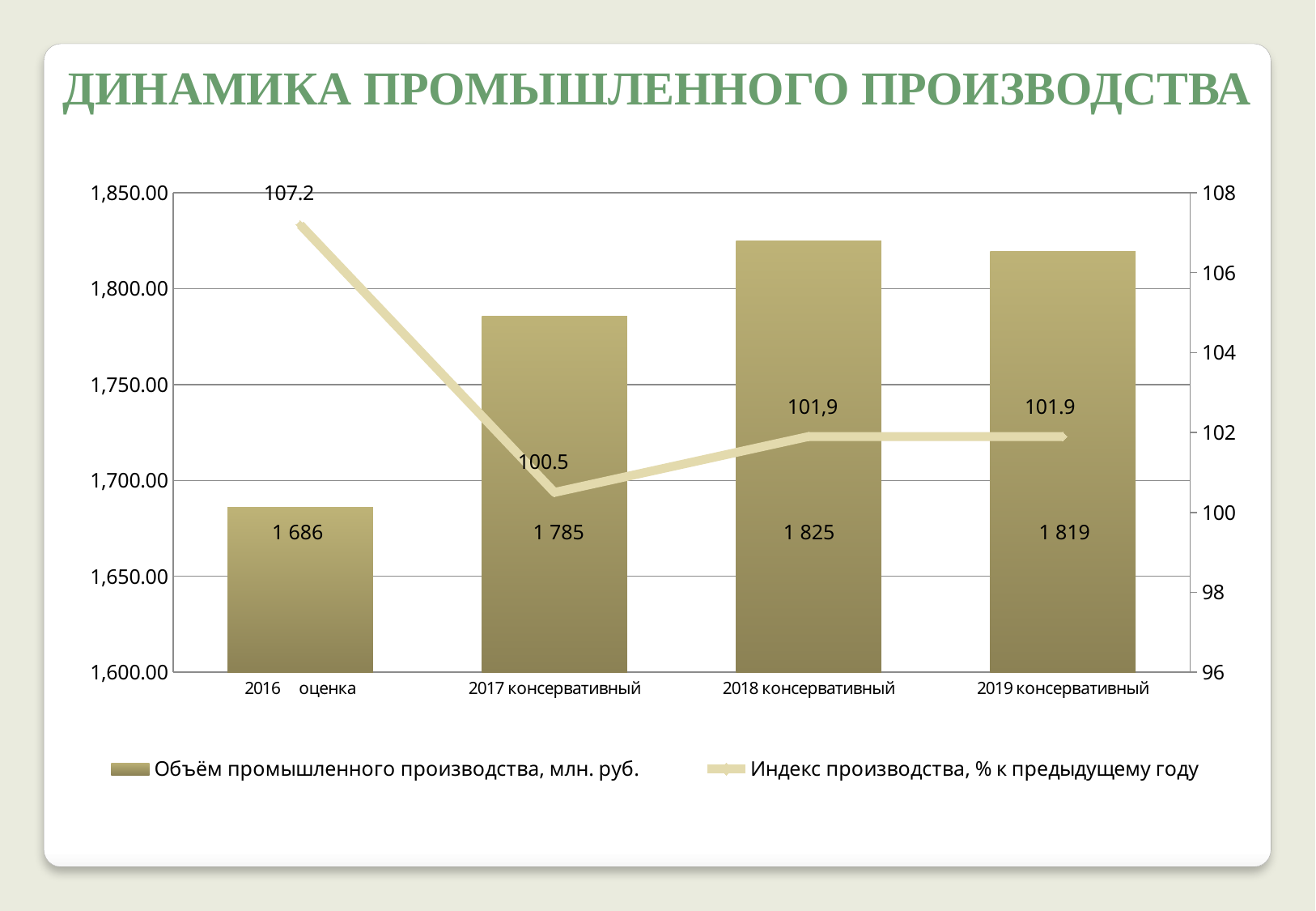
Which category has the highest value of Объём промышленного производства, млн. руб.? 2018 консервативный What is the value of Объём промышленного производства, млн. руб. for 2018 консервативный? 1 825 What is the difference between the Объём промышленного производства values for 2017 консервативный and 2016 оценка? 99 What is the value of Индекс производства, % к предыдущему году for 2017 консервативный? 100.5 What is the value of Индекс производства, % к предыдущему году for 2016 оценка? 107.2 What is the title of the slide? ДИНАМИКА ПРОМЫШЛЕННОГО ПРОИЗВОДСТВА Which is larger, the Объём промышленного производства value for 2018 консервативный or for 2019 консервативный? 2018 консервативный What kind of chart is shown on the slide? Combined bar and line chart How many categories are shown on the x axis? 4 How many series does the legend list? 2 What is the value of Объём промышленного производства, млн. руб. for 2016 оценка? 1 686 Which category has the lowest value of Индекс производства, % к предыдущему году? 2017 консервативный